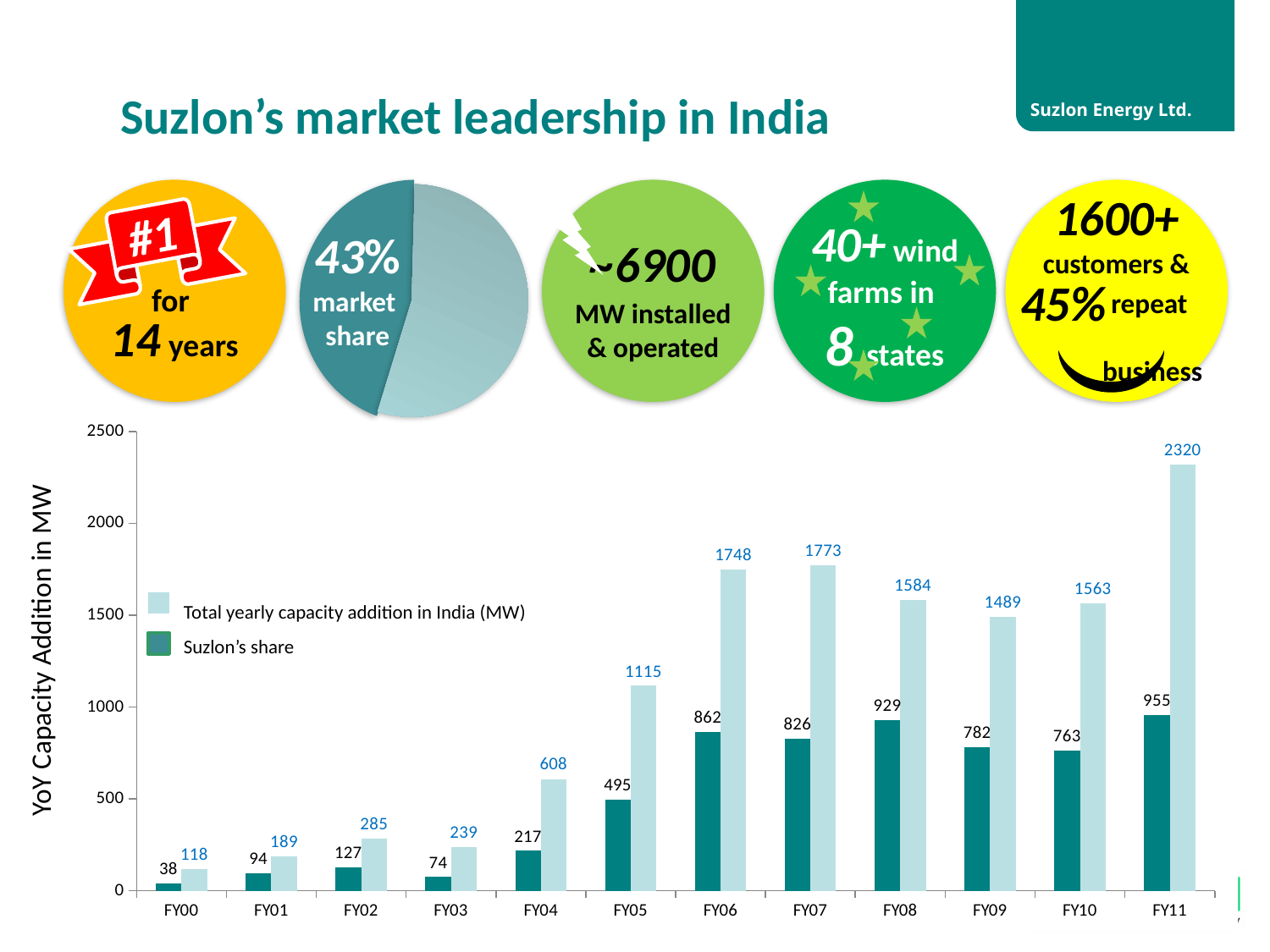
What is the difference between the total yearly capacity addition in India and Suzlon's share in FY06? 886 How many series does the chart legend list? 2 In which fiscal year was the total yearly capacity addition in India the highest? FY11 What was the total yearly capacity addition in India in FY11? 2320 In which fiscal year was Suzlon's share the lowest? FY00 What kind of chart is shown on the slide? Bar chart Did the total yearly capacity addition in India rise or fall from FY00 to FY06? Rise What was Suzlon's share in FY08? 929 Is Suzlon's share in FY05 greater or less than 500? less How many fiscal years are shown on the x axis of the chart? 12 What is the label of the y axis of the chart? YoY Capacity Addition in MW Which is larger: Suzlon's share in FY09 or Suzlon's share in FY10? FY09